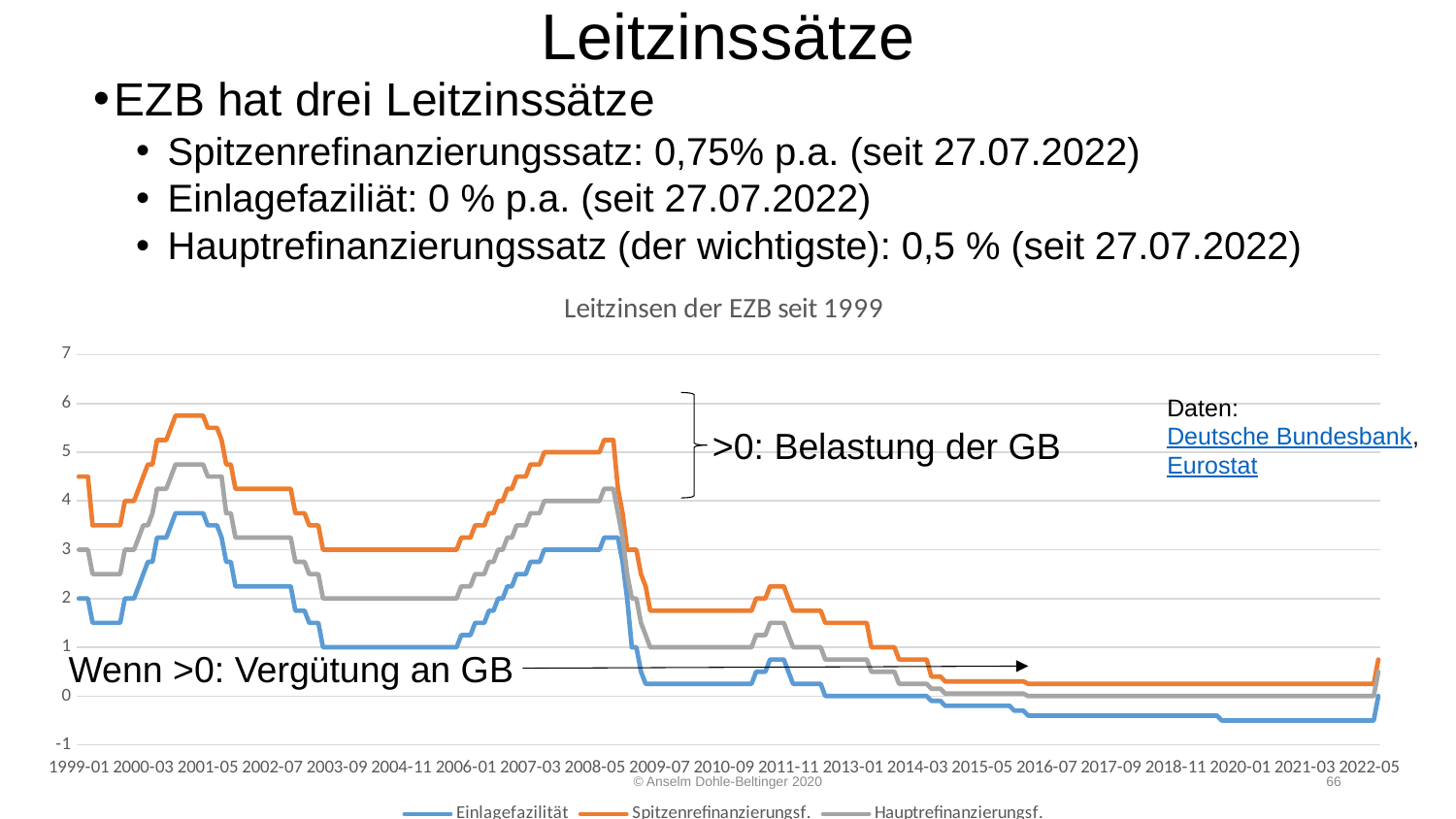
Is the peak value of Spitzenrefinanzierungsf. around 2001 greater or less than 5? greater How many series does the legend of the chart list? 3 Do the interest rates rise or fall between 2008-05 and 2009-07? fall Is the value of Spitzenrefinanzierungsf. around 2017-09 greater or less than 1? less Which series is the lowest line throughout the chart? Einlagefazilität Which colour is used for the Einlagefazilität series in the chart? blue Is the peak value of Einlagefazilität around 2001 greater or less than 3? greater Which series is the highest line throughout the chart? Spitzenrefinanzierungsf. What is the title of the chart? Leitzinsen der EZB seit 1999 Around 2008-05, which is larger: Spitzenrefinanzierungsf. or Einlagefazilität? Spitzenrefinanzierungsf. What kind of chart is shown on the slide? line chart